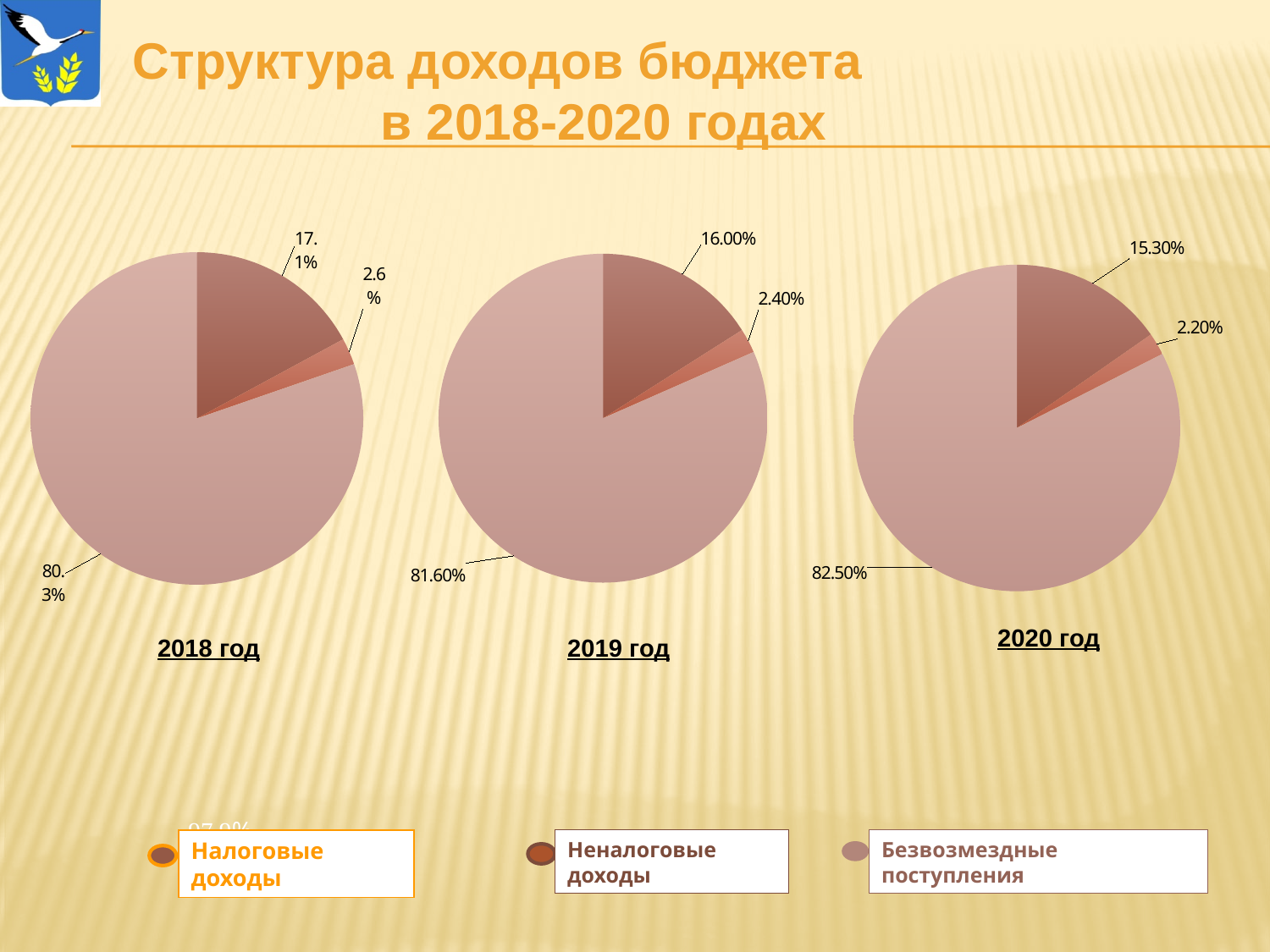
What kind of charts are shown on the slide? Pie charts In the 2020 год pie chart, what is the share of the largest slice? 82.50% In the 2018 год pie chart, what is the share of the largest slice? 80.3% In the 2019 год pie chart, what is the share of the largest slice? 81.60% In the 2020 год pie chart, what is the share of the smallest slice? 2.20% Across the three pie charts, does the share of the largest slice rise or fall from 2018 to 2020? Rises How many categories does the legend list? 3 In the 2018 год pie chart, what is the share of the smallest slice? 2.6% What is the difference between the largest slice in the 2020 год chart and the largest slice in the 2019 год chart? 0.90% How many pie charts are on the slide? 3 In the 2019 год pie chart, what is the share of the medium-sized (dark brown) slice? 16.00% Which legend category corresponds to the largest slice in all three pie charts? Безвозмездные поступления